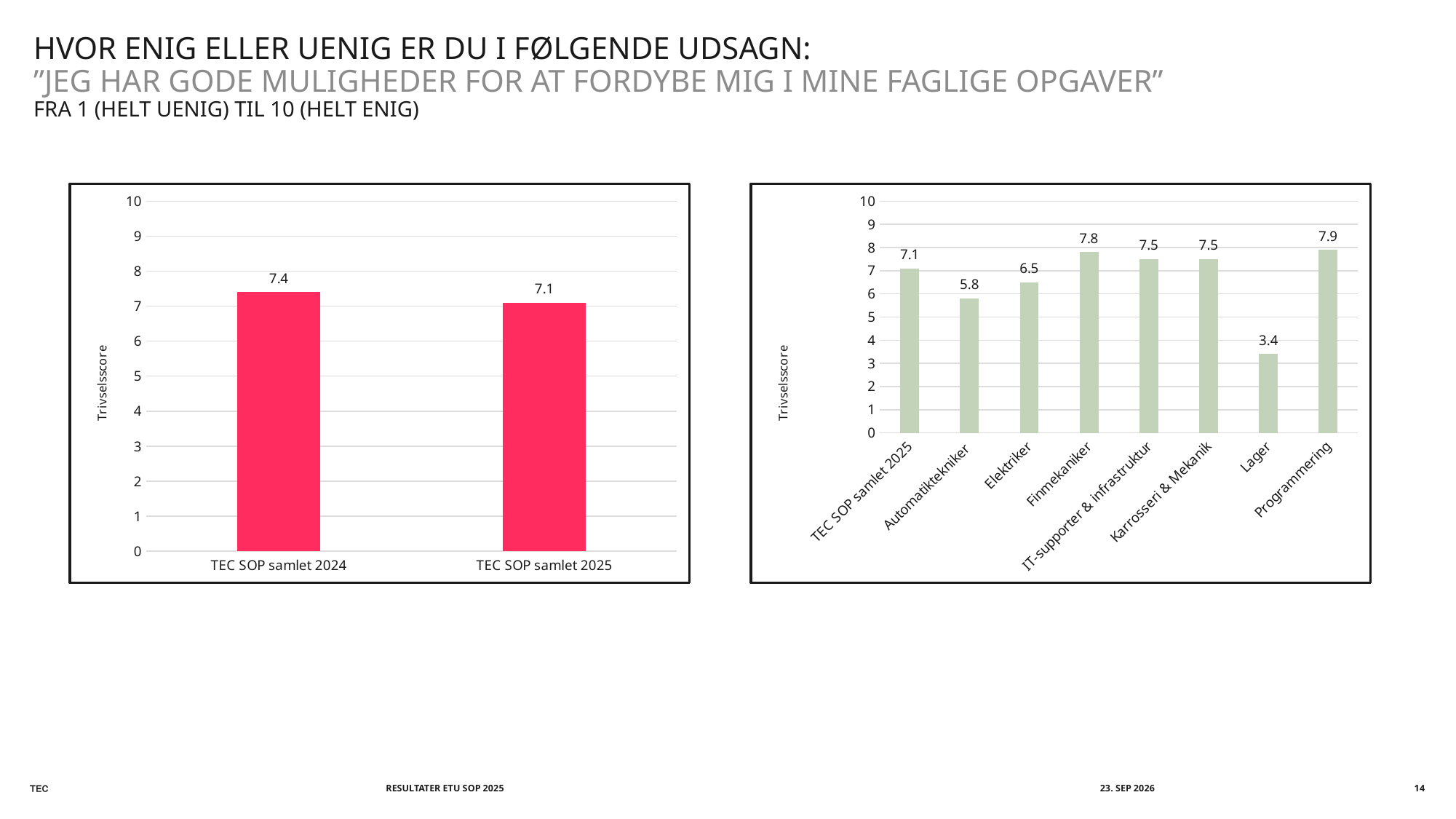
In the left chart, what is the value for TEC SOP samlet 2025? 7.1 What type of chart is the right chart? bar chart In the right chart, what is the value for Lager? 3.4 In the right chart, which is larger, Elektriker or IT-supporter & infrastruktur? IT-supporter & infrastruktur In the right chart, what is the difference between Finmekaniker and Elektriker? 1.3 In the left chart, what is the difference between the 2024 and 2025 values? 0.3 In the right chart, which category has the highest value? Programmering In the left chart, what is the value for TEC SOP samlet 2024? 7.4 In the right chart, which category has the lowest value? Lager In the right chart, what is the value for Automatiktekniker? 5.8 In the left chart, do the values rise or fall from 2024 to 2025? fall How many categories are shown in the right chart? 8